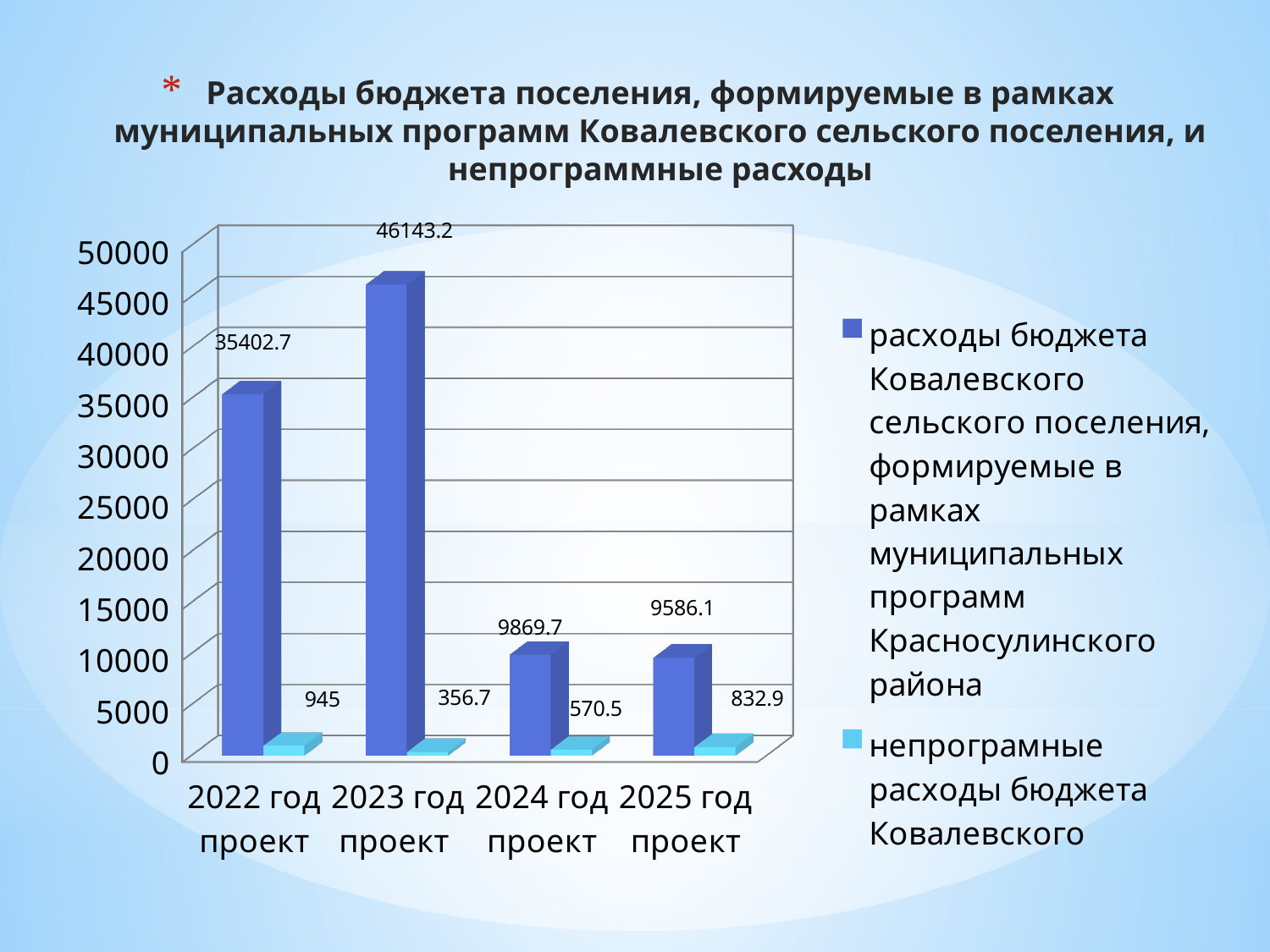
What is the difference between the non-program expenses for 2022 год проект and 2023 год проект? 588.3 Which is larger: the program expenses for 2024 год проект or for 2025 год проект? 2024 год проект What kind of chart is shown on the slide? Bar chart What is the value of the non-program expenses (непрограмные расходы) for 2022 год проект? 945 How many series does the legend list? 2 What is the value of the non-program expenses for 2024 год проект? 570.5 What is the difference between the program expenses for 2023 год проект and 2022 год проект? 10740.5 In which year are the non-program expenses lowest? 2023 год проект How many year categories are shown on the x axis? 4 What is the value of the program expenses (расходы бюджета ... в рамках муниципальных программ) for 2023 год проект? 46143.2 In which year are the program expenses highest? 2023 год проект What is the value of the program expenses for 2025 год проект? 9586.1